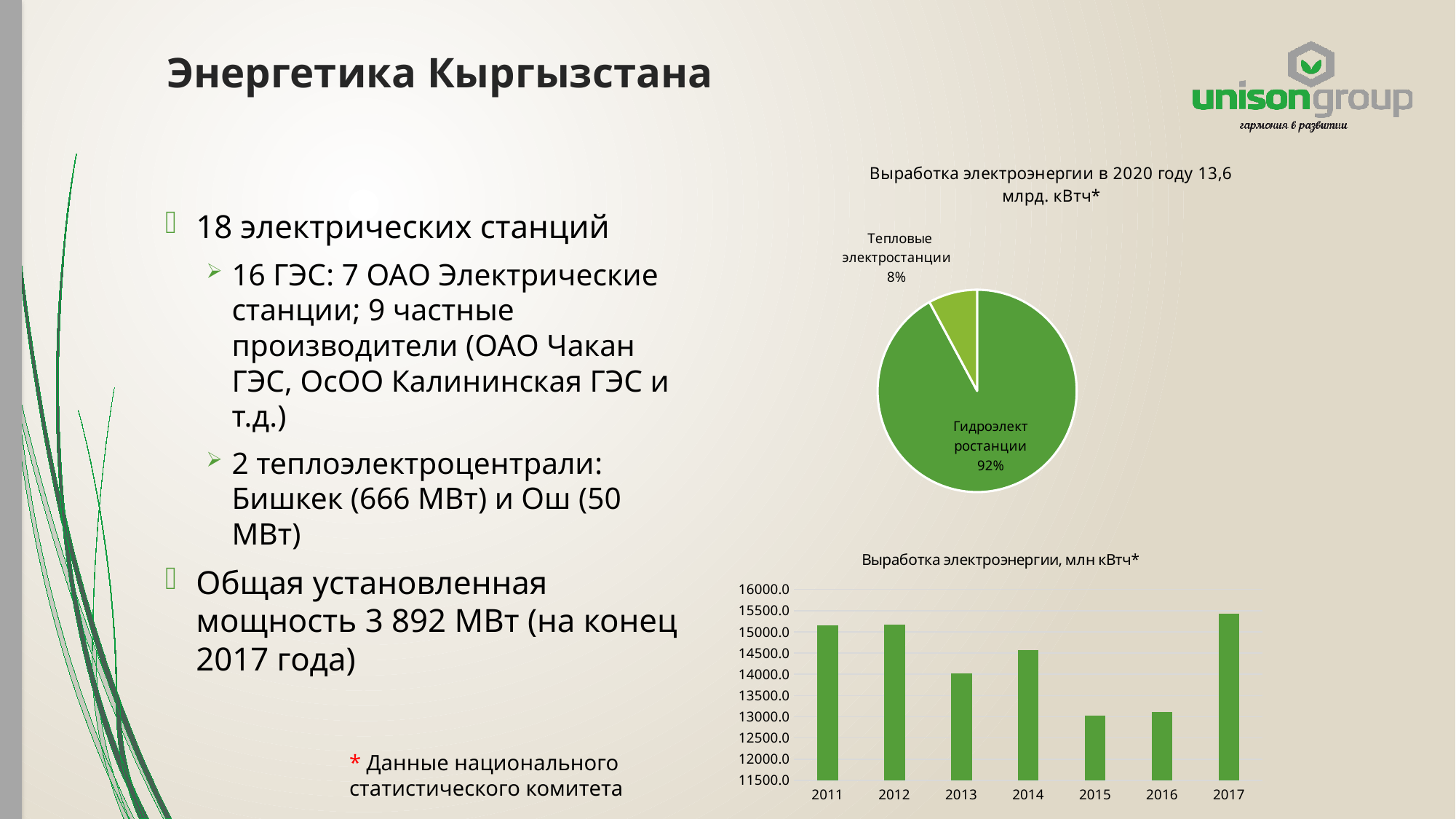
On the bar chart titled 'Выработка электроэнергии, млн кВтч*', which is larger, the value for 2011 or the value for 2013? 2011 On the pie chart at the top right, which slice is the largest? Гидроэлектростанции On the bar chart titled 'Выработка электроэнергии, млн кВтч*', how many years are shown on the x axis? 7 On the bar chart titled 'Выработка электроэнергии, млн кВтч*', is the value for 2014 greater or less than 14000.0? greater On the bar chart titled 'Выработка электроэнергии, млн кВтч*', which year has the highest bar? 2017 On the pie chart titled 'Выработка электроэнергии в 2020 году 13,6 млрд. кВтч*', what share is shown for Гидроэлектростанции? 92% On the bar chart titled 'Выработка электроэнергии, млн кВтч*', is the value for 2015 greater or less than 13500.0? less On the pie chart at the top right, how many slices are there? 2 On the pie chart titled 'Выработка электроэнергии в 2020 году 13,6 млрд. кВтч*', what share is shown for Тепловые электростанции? 8% On the bar chart titled 'Выработка электроэнергии, млн кВтч*', is the value for 2017 greater or less than 15000.0? greater What kind of chart is the chart titled 'Выработка электроэнергии, млн кВтч*'? bar chart What is the title of the pie chart at the top right of the slide? Выработка электроэнергии в 2020 году 13,6 млрд. кВтч*